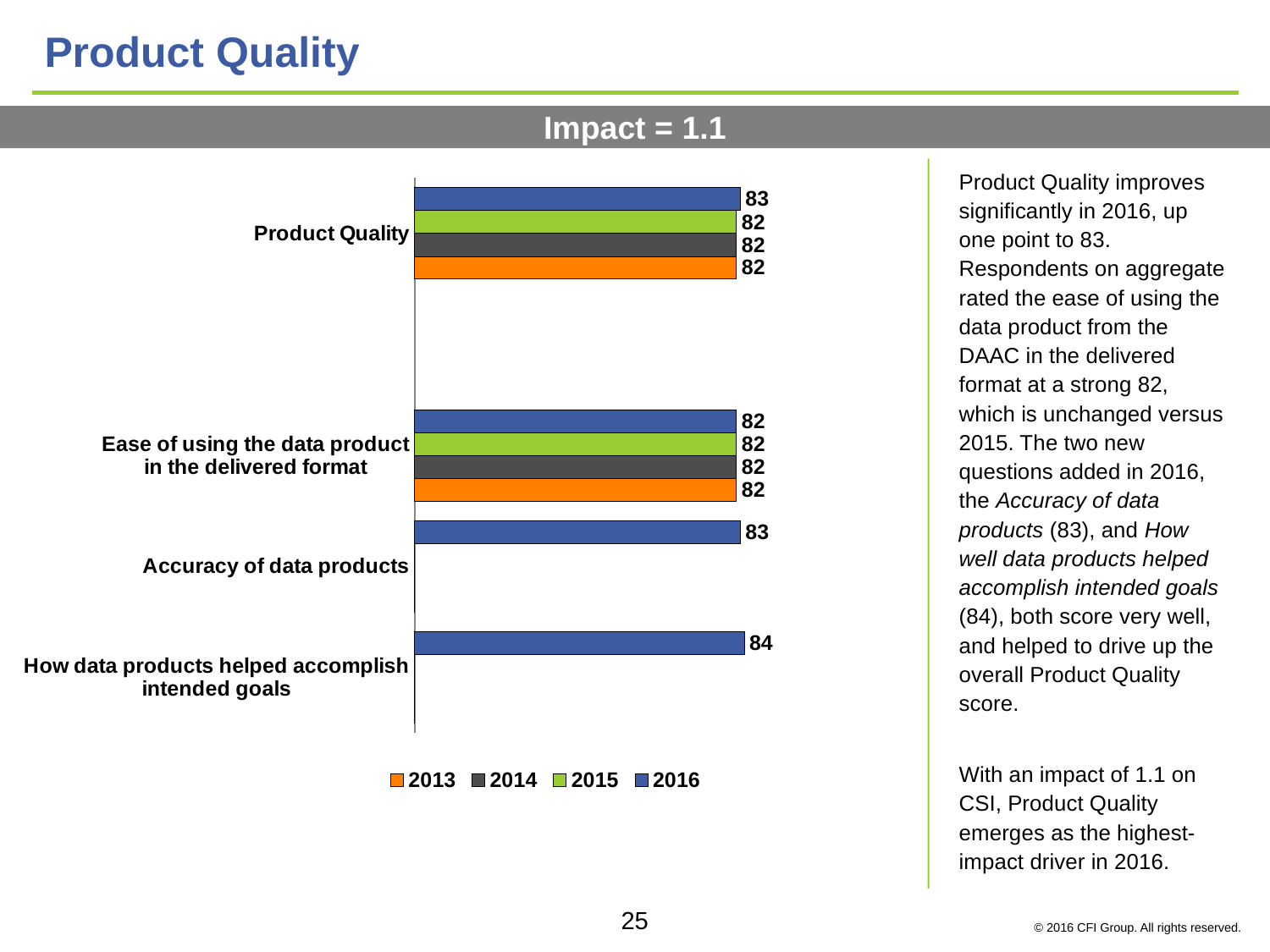
What is the 2015 value for Product Quality? 82 What is the 2016 value for How data products helped accomplish intended goals? 84 Which category has the highest 2016 value? How data products helped accomplish intended goals How many series does the legend list? 4 What kind of chart is shown on the slide? Bar chart What is the difference between the 2016 value for How data products helped accomplish intended goals and the 2016 value for Ease of using the data product in the delivered format? 2 How many categories are shown on the chart? 4 Which category has the lowest 2016 value? Ease of using the data product in the delivered format What is the 2016 value for Accuracy of data products? 83 What is the 2016 value for Product Quality? 83 Which is larger: the 2016 value for Product Quality or the 2014 value for Product Quality? 2016 What is the 2013 value for Ease of using the data product in the delivered format? 82